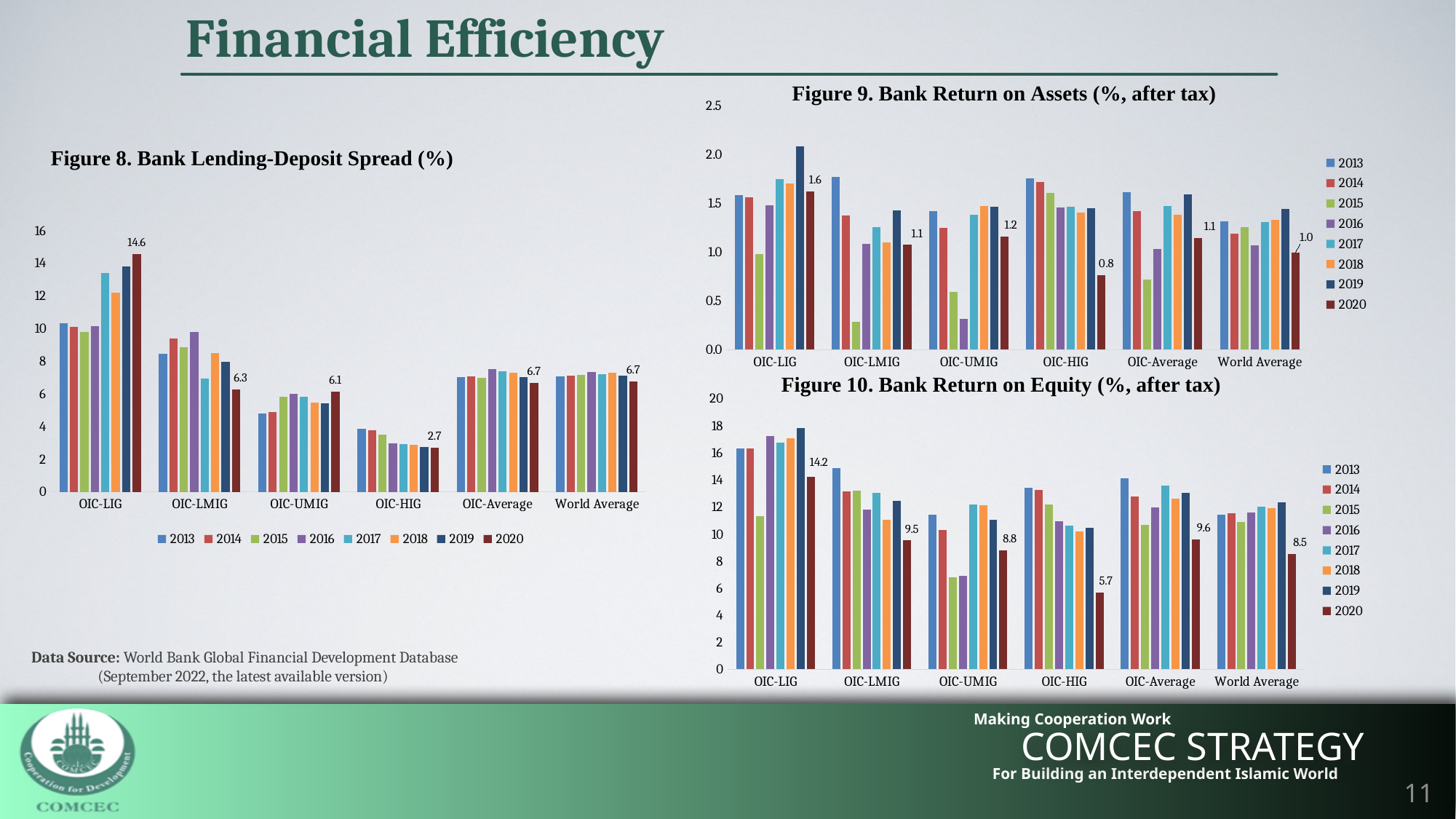
In Figure 10 (Bank Return on Equity), what is the 2020 value for OIC-Average? 9.6 In Figure 10 (Bank Return on Equity), which is larger, the 2020 value for OIC-LMIG or for World Average? OIC-LMIG In Figure 9 (Bank Return on Assets), is the 2019 value for OIC-LIG greater or less than 2.0? greater How many series does the legend of Figure 10 (Bank Return on Equity) list? 8 In Figure 8 (Bank Lending-Deposit Spread), what is the difference between the 2020 values for OIC-LIG and OIC-LMIG? 8.3 In Figure 10 (Bank Return on Equity), what is the difference between the 2020 values for OIC-LIG and OIC-HIG? 8.5 In Figure 8 (Bank Lending-Deposit Spread), what is the 2020 value for OIC-LIG? 14.6 In Figure 9 (Bank Return on Assets), which category has the highest 2020 value? OIC-LIG In Figure 8 (Bank Lending-Deposit Spread), which category has the lowest 2020 value? OIC-HIG In Figure 9 (Bank Return on Assets), what is the 2020 value for OIC-UMIG? 1.2 In Figure 8 (Bank Lending-Deposit Spread), what is the 2020 value for OIC-HIG? 2.7 What kind of chart is Figure 8 (Bank Lending-Deposit Spread)? Bar chart